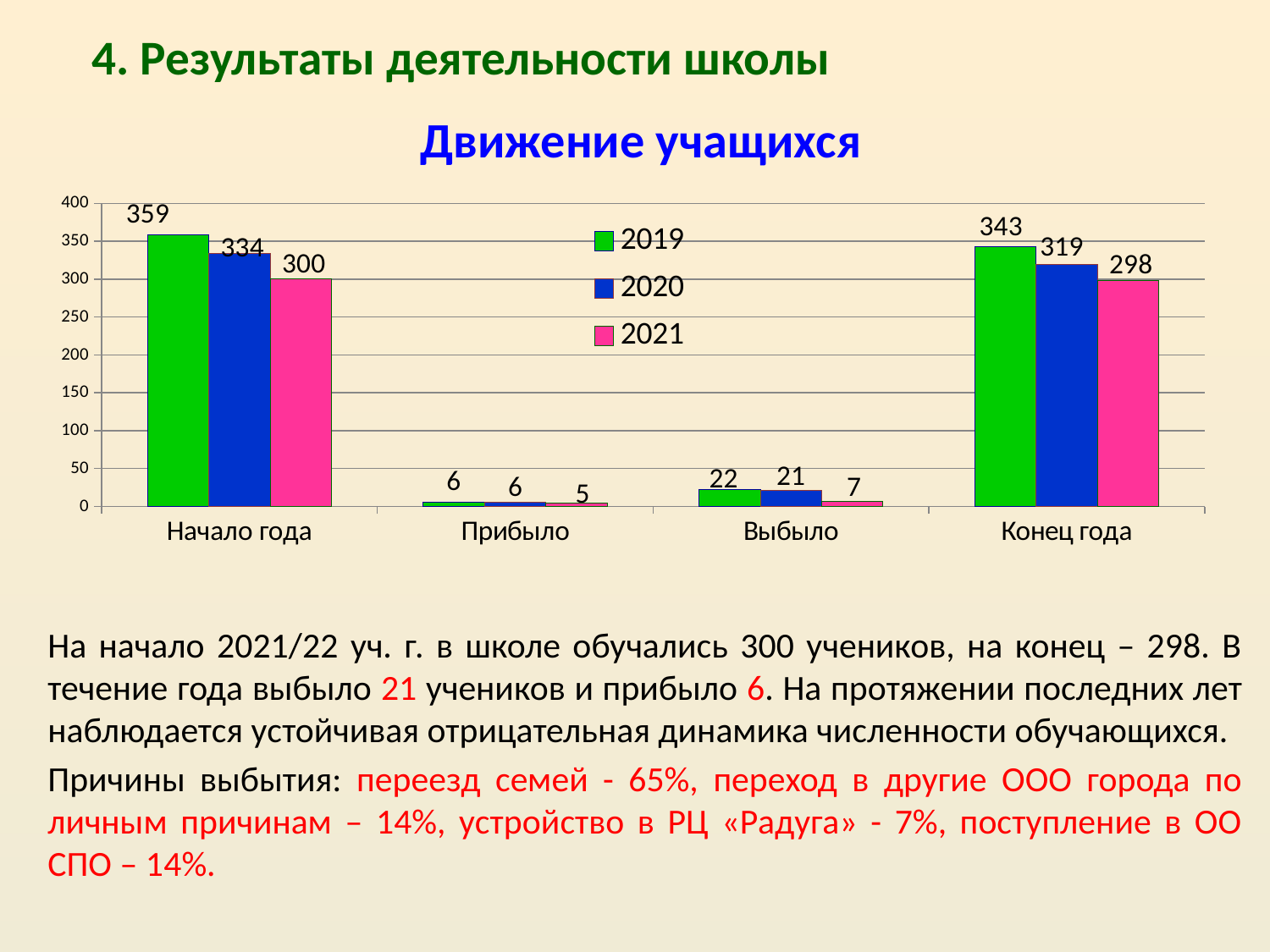
What is the value for 2021 in the "Прибыло" category? 5 Which is larger: the 2020 value for "Начало года" or the 2020 value for "Конец года"? Начало года Which year has the highest value in the "Начало года" category? 2019 What is the value for 2020 in the "Выбыло" category? 21 What type of chart is shown on the slide? Bar chart Which year has the lowest value in the "Выбыло" category? 2021 How many series does the legend list? 3 What is the title of the chart? Движение учащихся How many categories are shown on the x axis? 4 What is the difference between the 2019 and 2021 values in the "Конец года" category? 45 What is the value for 2021 in the "Конец года" category? 298 What is the value for 2019 in the "Начало года" category? 359